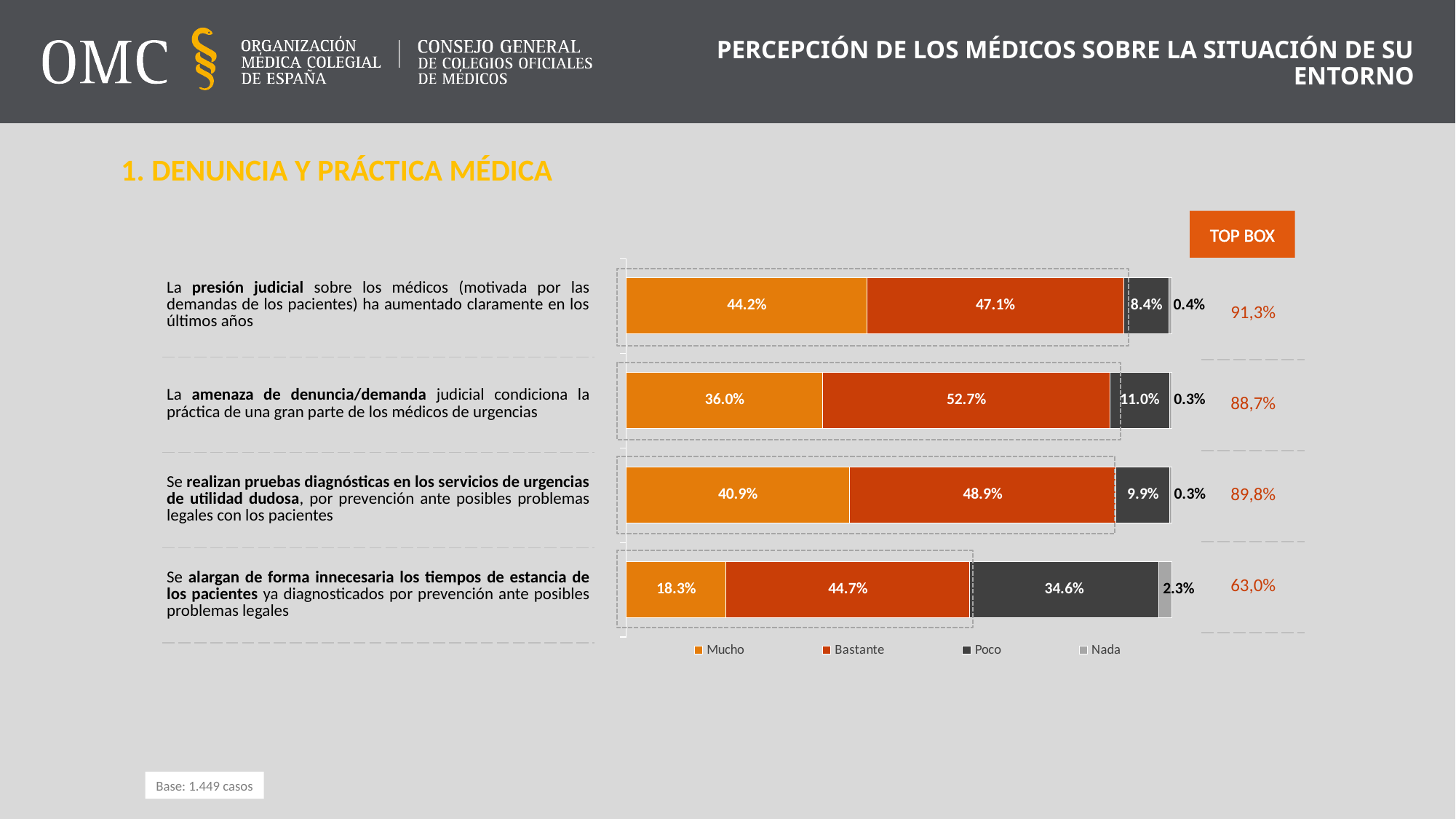
How many series does the legend list? 4 Which is larger: the "Nada" value for the statement about prolonged patient stays (se alargan los tiempos de estancia) or the "Nada" value for the statement about judicial pressure (presión judicial)? Se alargan los tiempos de estancia (2.3%) What is the difference between the "Bastante" and "Mucho" values for the statement about the threat of a complaint/lawsuit (amenaza de denuncia/demanda)? 16.7% What is the "Poco" value for the statement that patients' stays are unnecessarily prolonged (se alargan de forma innecesaria los tiempos de estancia)? 34.6% What percentage of doctors answered "Mucho" to the statement that judicial pressure (presión judicial) on doctors has clearly increased in recent years? 44.2% What are the four legend entries of the chart? Mucho, Bastante, Poco, Nada What is the TOP BOX value shown for the statement about diagnostic tests of doubtful usefulness (pruebas diagnósticas de utilidad dudosa)? 89,8% Which statement has the lowest TOP BOX value? Se alargan de forma innecesaria los tiempos de estancia de los pacientes What is the "Bastante" value for the statement that the threat of a complaint/lawsuit (amenaza de denuncia/demanda) conditions the practice of many emergency doctors? 52.7% How many statements (bars) are shown in the chart? 4 Which statement has the highest "Mucho" percentage? La presión judicial sobre los médicos ha aumentado claramente en los últimos años What kind of chart is shown on the slide? Stacked bar chart